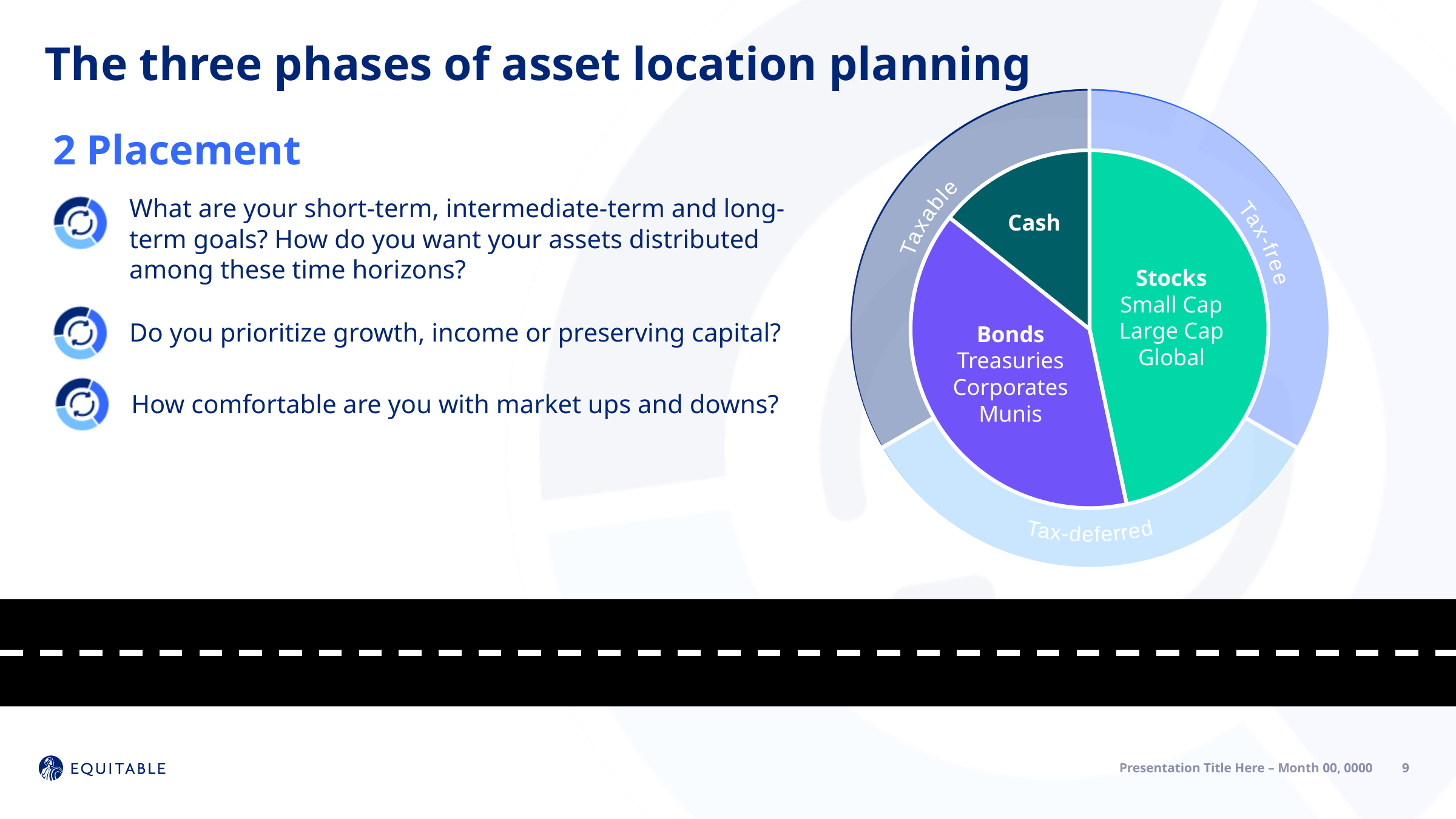
Which slice is larger in the pie chart, Bonds or Cash? Bonds What are the three labels on the outer ring around the pie chart? Taxable, Tax-free, Tax-deferred What colour is the Stocks slice of the pie chart? green Which slice of the pie chart is the smallest? Cash Which slice of the pie chart is the largest? Stocks How many slices does the pie chart have? 3 What kind of chart is shown on the slide? pie chart Which slice is larger in the pie chart, Stocks or Bonds? Stocks Which slice is larger in the pie chart, Cash or Stocks? Stocks